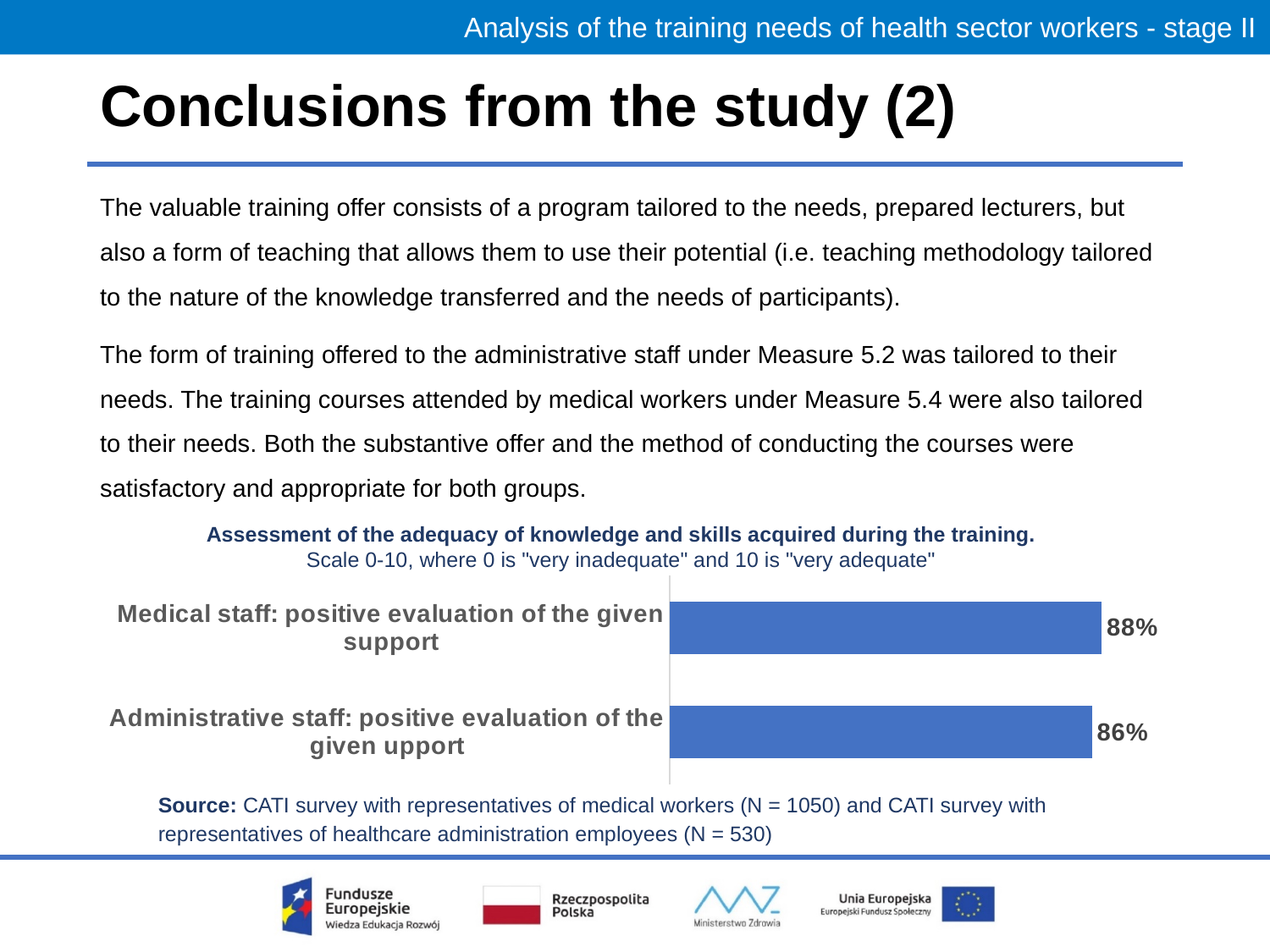
Which category has the lowest value? Administrative staff: positive evaluation of the given upport What colour are the bars in the chart? Blue What is the value for Medical staff: positive evaluation of the given support? 88% What is the title of the chart? Assessment of the adequacy of knowledge and skills acquired during the training. Which is larger: the value for medical staff or the value for administrative staff? Medical staff How many categories are shown in the chart? 2 What kind of chart is shown on the slide? Bar chart What is the value for Administrative staff: positive evaluation of the given upport? 86% What is the difference between the value for medical staff and the value for administrative staff? 2% Which category has the highest value? Medical staff: positive evaluation of the given support